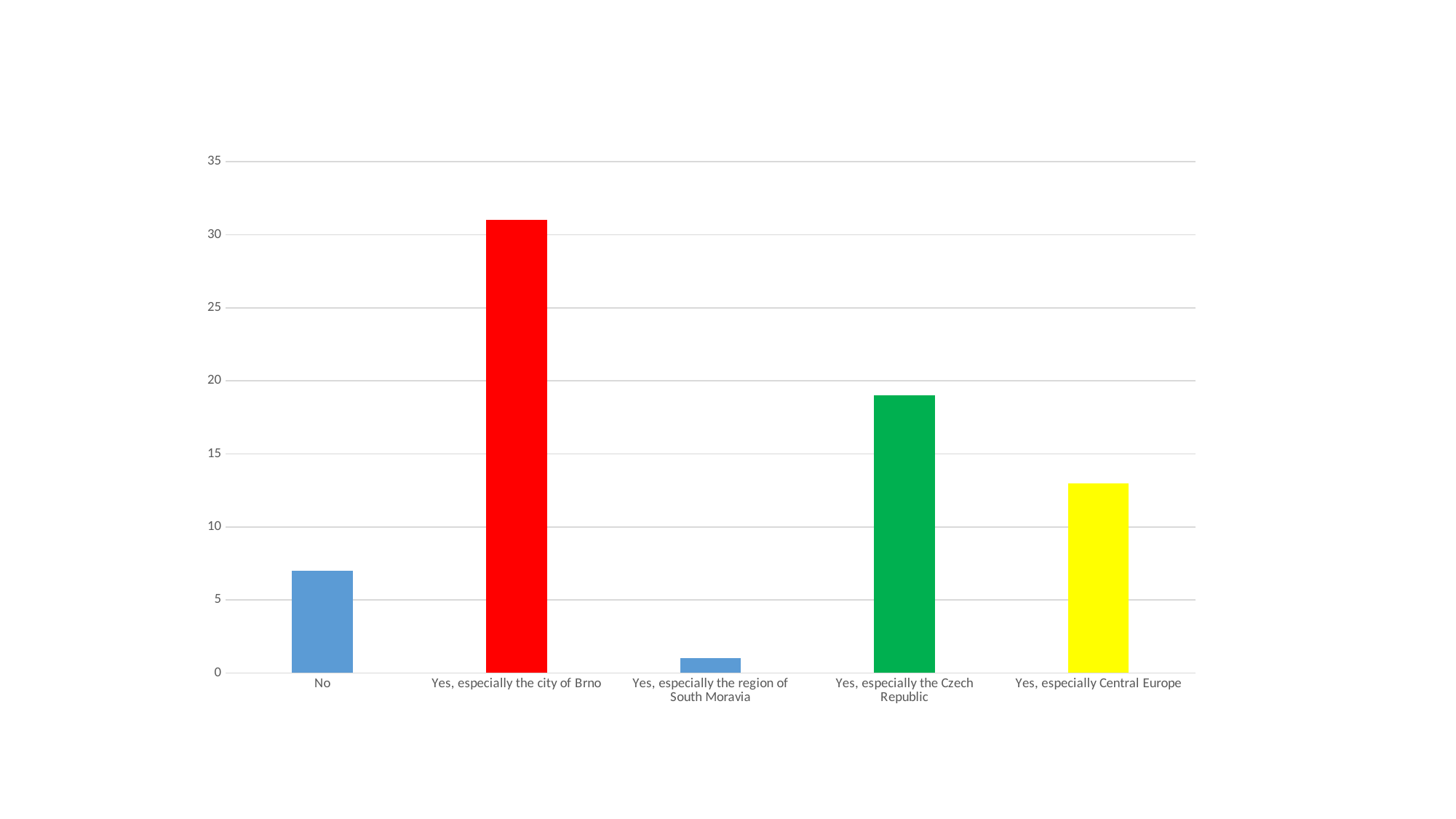
Which is larger, the value for "No" or the value for "Yes, especially Central Europe"? Yes, especially Central Europe Which is larger, the value for "Yes, especially the Czech Republic" or the value for "Yes, especially Central Europe"? Yes, especially the Czech Republic Which category has the highest bar? Yes, especially the city of Brno Is the value for "No" greater or less than 10? less Is the value for "Yes, especially the Czech Republic" greater or less than 15? greater Is the value for "Yes, especially Central Europe" greater or less than 15? less What kind of chart is shown on the slide? bar chart Which category has the lowest bar? Yes, especially the region of South Moravia What colour is the bar for "Yes, especially the city of Brno"? red How many categories are shown on the x axis of the chart? 5